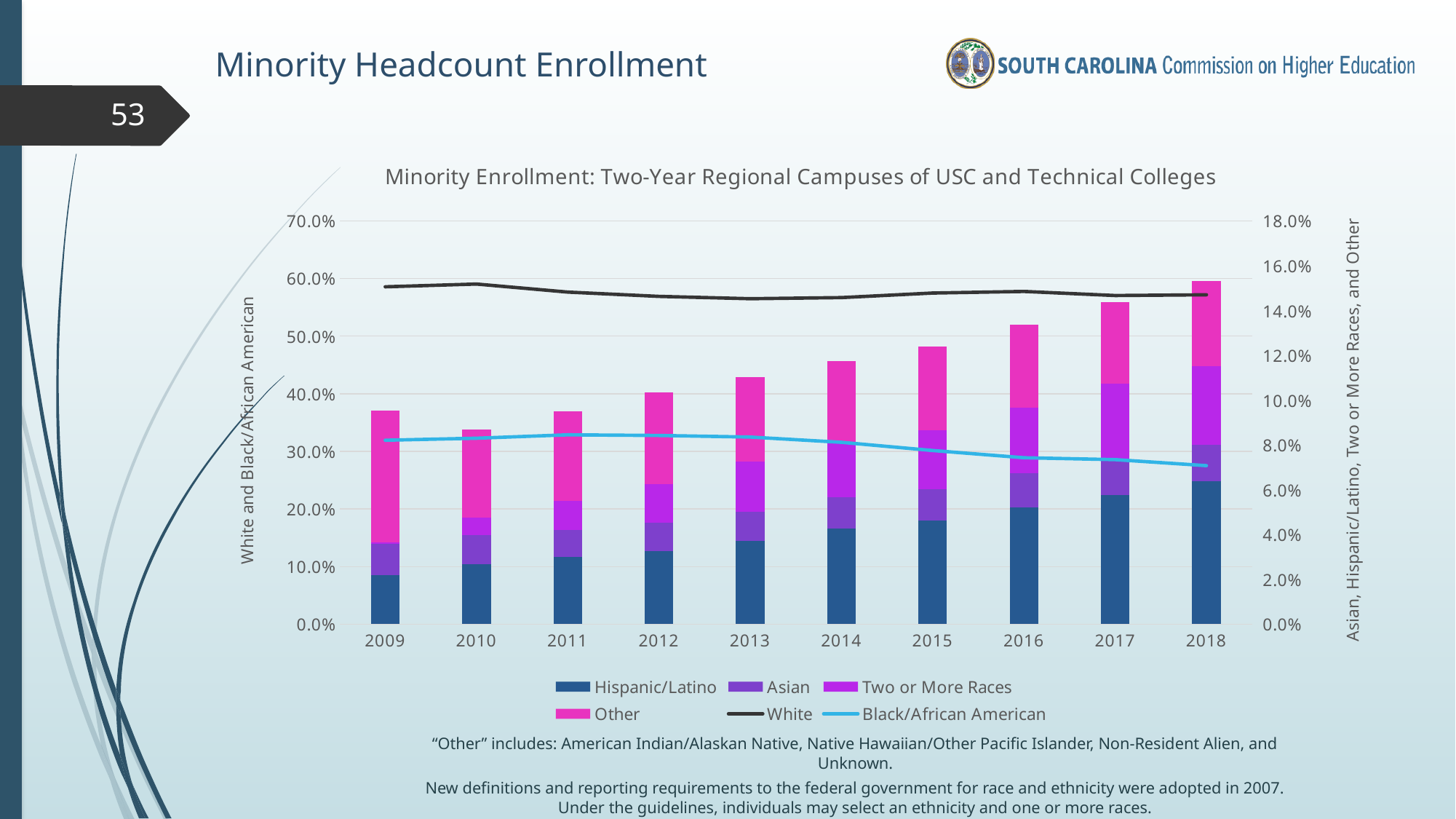
In which year is the stacked bar the shortest? 2010 Do the stacked bar totals rise or fall from 2009 to 2018? Rise What is the title of the chart? Minority Enrollment: Two-Year Regional Campuses of USC and Technical Colleges Is the value of the Black/African American line in 2018 greater or less than 30.0%? less Does the Black/African American line rise or fall overall from 2009 to 2018? Fall In 2015, which is larger: the White line or the Black/African American line? White Is the total of the stacked bar for 2018 greater or less than 14.0% on the right axis? greater How many series does the chart's legend list? 6 What kind of chart is shown on the slide? A stacked bar chart combined with line series How many years are shown along the x axis of the chart? 10 In which year is the stacked bar the tallest? 2018 Is the value of the White line in 2009 greater or less than 50.0%? greater